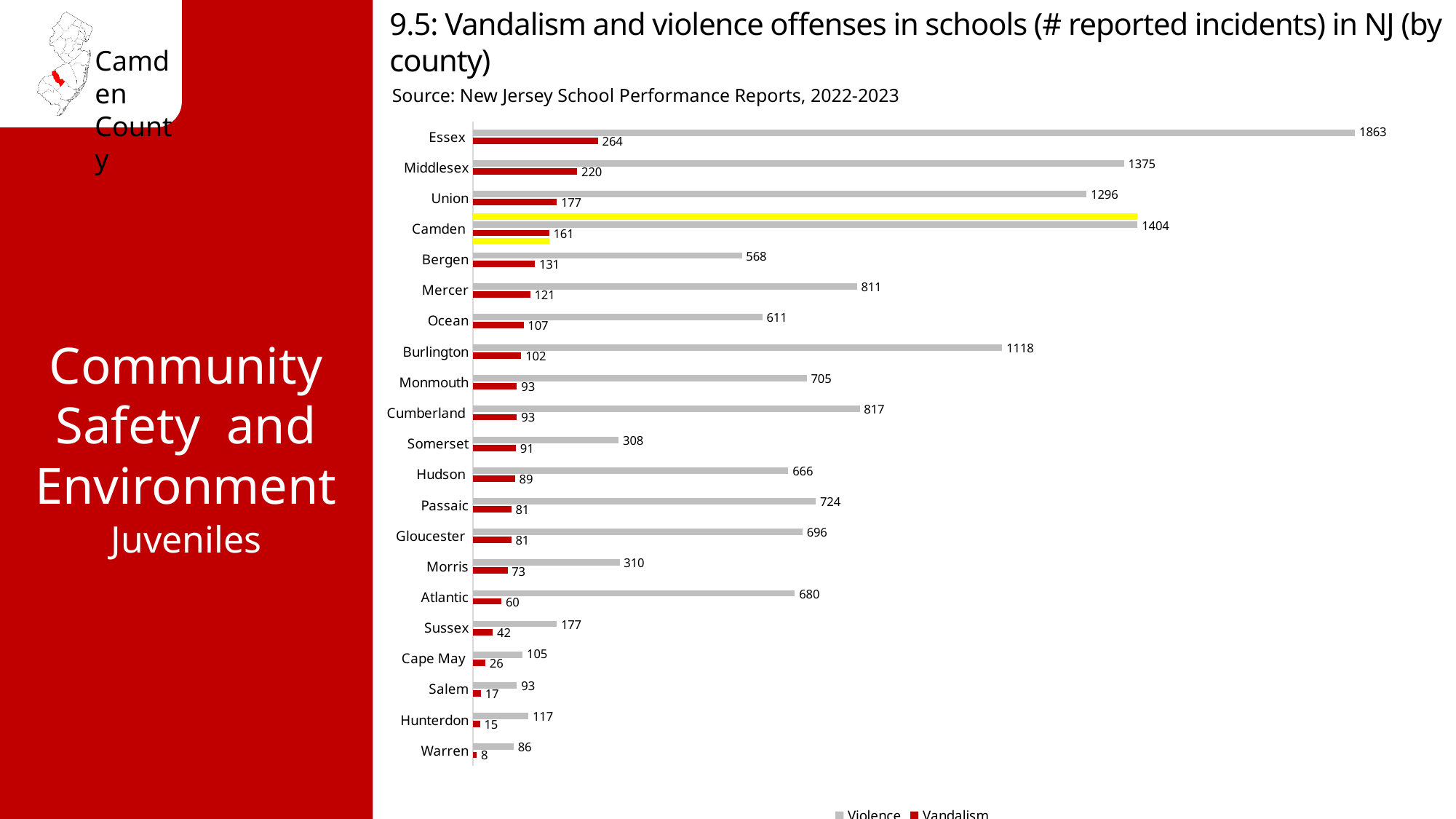
How many counties are shown on the chart? 21 Which county has more reported vandalism incidents, Middlesex or Union? Middlesex Which county has the lowest number of reported vandalism incidents? Warren Which county has the highest number of reported violence incidents? Essex What kind of chart is shown on the slide? Bar chart Which series is shown in red on the chart? Vandalism What is the number of reported vandalism incidents in schools for Camden County? 161 What is the number of reported violence incidents in schools for Essex County? 1863 How many series does the legend list? 2 What is the number of reported violence incidents for Burlington County? 1118 What is the difference between vandalism incidents in Essex and Middlesex counties? 44 What is the difference between the violence incidents in Camden and Union counties? 108